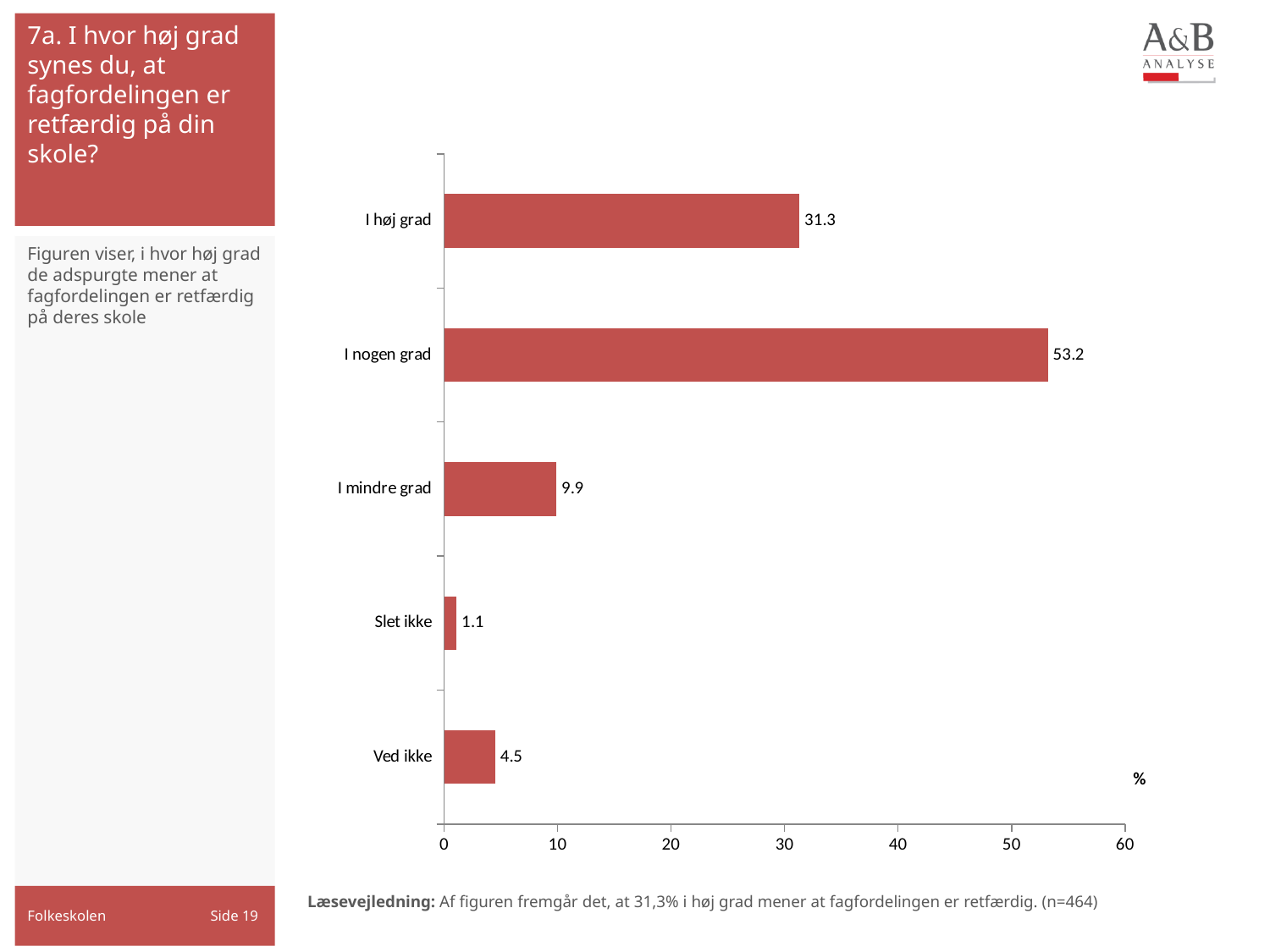
What is the value for "I høj grad"? 31.3 Is the value for "I høj grad" greater or less than 30? greater Which is larger, the value for "I mindre grad" or the value for "Ved ikke"? I mindre grad What is the value for "Ved ikke"? 4.5 What is the value for "Slet ikke"? 1.1 What is the value for "I nogen grad"? 53.2 What kind of chart is shown on the slide? Bar chart How many categories are shown in the chart? 5 What is the difference between the values for "I nogen grad" and "I høj grad"? 21.9 Which category has the highest value? I nogen grad What is the maximum value shown on the horizontal axis? 60 Which category has the lowest value? Slet ikke